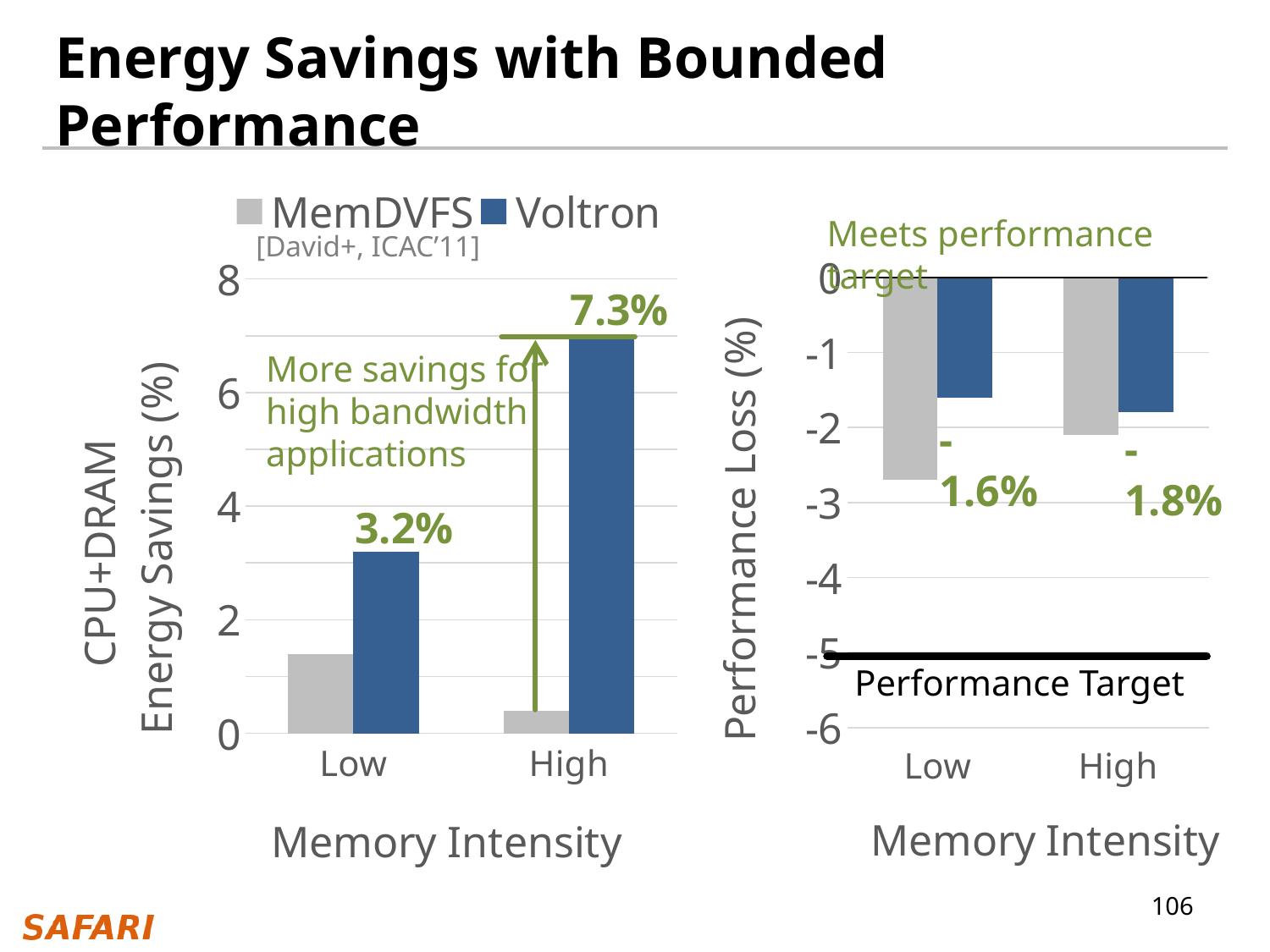
In the left chart (CPU+DRAM Energy Savings), which series has the higher value for Low memory intensity, MemDVFS or Voltron? Voltron How many memory intensity categories are shown on the x axis of the left chart? 2 In the left chart (CPU+DRAM Energy Savings), do the Voltron values rise or fall from Low to High memory intensity? rise What is the x-axis title of the right chart (Performance Loss)? Memory Intensity In the left chart (CPU+DRAM Energy Savings), is the MemDVFS value for Low memory intensity greater or less than 2? less In the left chart (CPU+DRAM Energy Savings), what is the difference between the Voltron values for High and Low memory intensity? 4.1% In the left chart (CPU+DRAM Energy Savings), what is the Voltron value for High memory intensity? 7.3% How many series does the legend list for the charts on this slide? 2 What kind of chart is the left chart (CPU+DRAM Energy Savings)? Bar chart In the right chart (Performance Loss), what is the Voltron value for High memory intensity? -1.8% In the left chart (CPU+DRAM Energy Savings), what is the Voltron value for Low memory intensity? 3.2% In the right chart (Performance Loss), what is the Voltron value for Low memory intensity? -1.6%